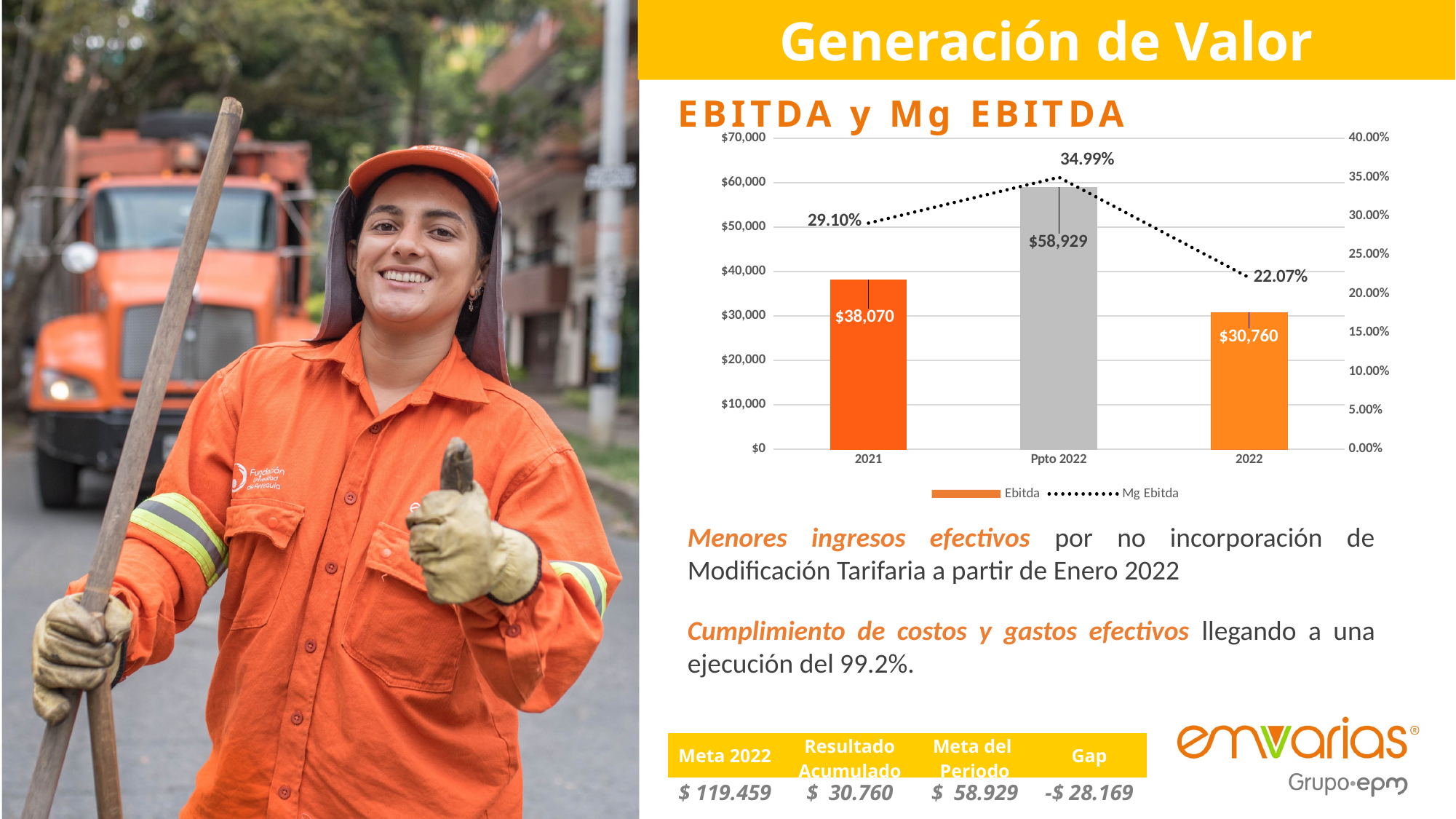
How many series does the chart legend list? 2 What is the Mg Ebitda value for 2022? 22.07% What is the Ebitda value for 2021? $38,070 Which category has the lowest Mg Ebitda? 2022 What is the difference between the Ebitda for Ppto 2022 and the Ebitda for 2022? $28,169 How many categories are shown on the x axis of the chart? 3 What is the Ebitda value for Ppto 2022? $58,929 What is the Ebitda value for 2022? $30,760 Which category has the highest Ebitda? Ppto 2022 Which is larger, the Ebitda for 2021 or the Ebitda for 2022? 2021 What is the title of the chart? EBITDA y Mg EBITDA What is the Mg Ebitda value for Ppto 2022? 34.99%